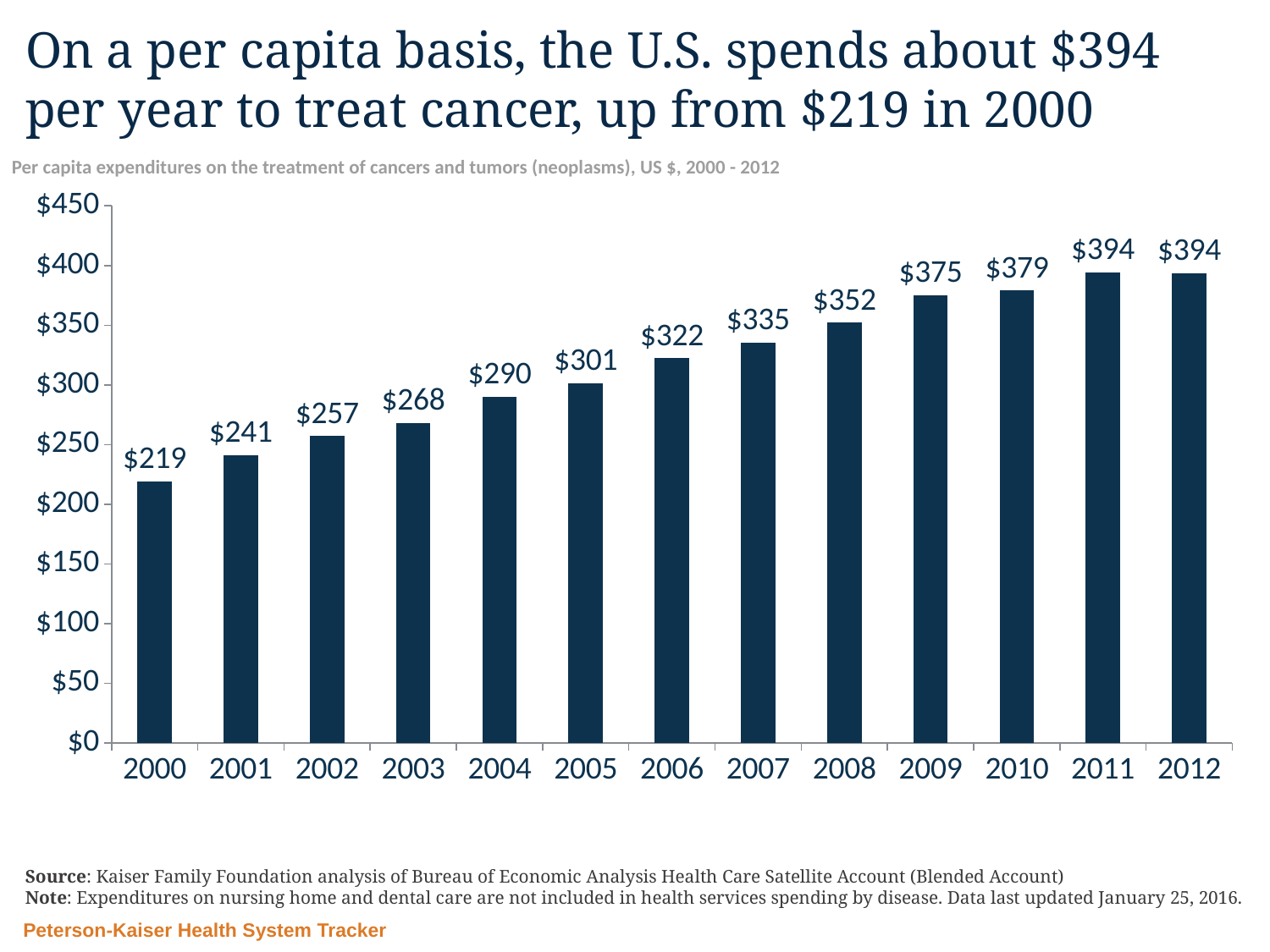
What kind of chart is shown on the slide? Bar chart Which two years share the highest per capita expenditure value on the chart? 2011 and 2012 What is the per capita expenditure on the treatment of cancers and tumors in 2005? $301 What is the per capita expenditure on the treatment of cancers and tumors in 2009? $375 Do per capita expenditures on the treatment of cancers and tumors rise or fall from 2000 to 2012? Rise Which year has the larger per capita expenditure, 2003 or 2006? 2006 Which year has the lowest per capita expenditure on the treatment of cancers and tumors? 2000 What is the difference between the per capita expenditure in 2008 and in 2007? $17 How many years are shown on the chart? 13 Is the per capita expenditure in 2004 greater or less than $300? less What is the maximum value shown on the vertical axis of the chart? $450 What is the difference between the per capita expenditure in 2012 and in 2000? $175